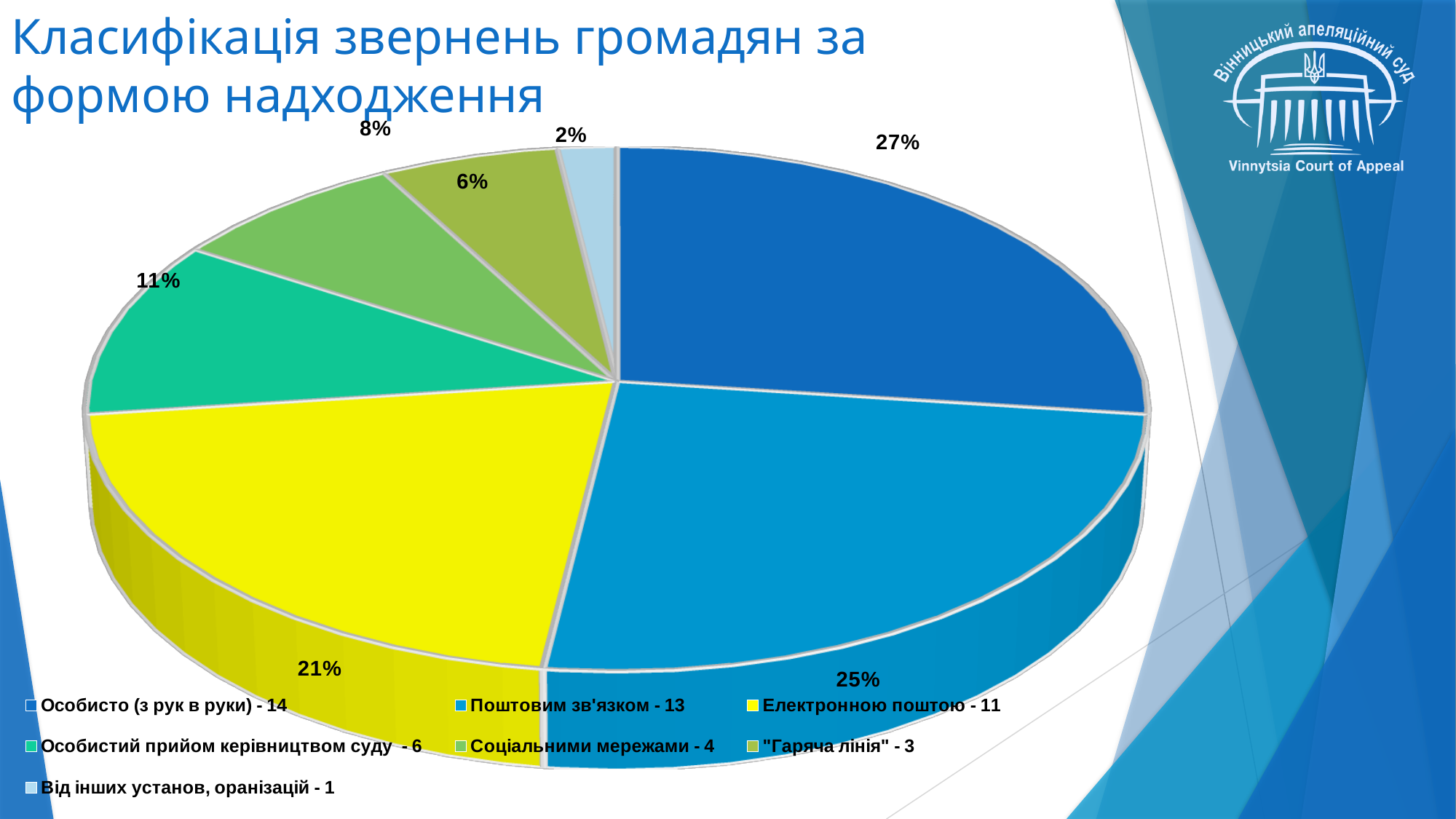
Which slice is larger: "Електронною поштою" or "Особистий прийом керівництвом суду"? Електронною поштою Which category has the smallest slice of the pie? Від інших установ, оранізацій According to the legend, how many appeals were received via "Поштовим зв'язком"? 13 What percentage share does the slice for "Особистий прийом керівництвом суду" have? 11% What kind of chart is shown on the slide? pie chart What percentage share does the slice for "Від інших установ, оранізацій" have? 2% What is the difference in percentage points between the "Соціальними мережами" slice (8%) and the "Гаряча лінія" slice (6%)? 2 What percentage share does the slice for "Особисто (з рук в руки)" have? 27% How many slices does the pie chart have? 7 Which category has the largest slice of the pie? Особисто (з рук в руки)